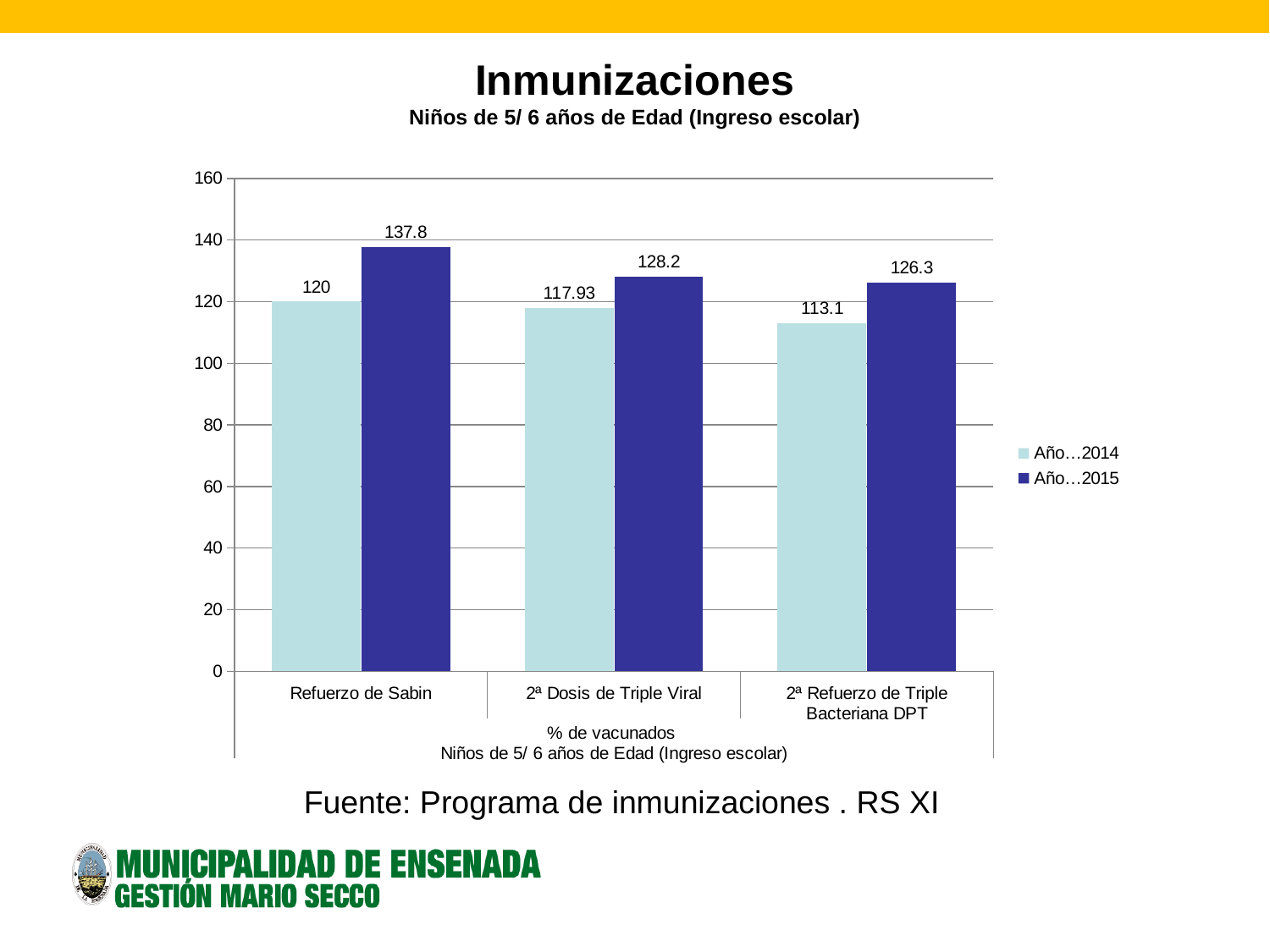
What is the difference between the Año…2015 and Año…2014 values for Refuerzo de Sabin? 17.8 Which is larger for 2ª Dosis de Triple Viral: the Año…2014 value or the Año…2015 value? Año…2015 What is the value for 2ª Refuerzo de Triple Bacteriana DPT in Año…2014? 113.1 What is the title of the chart? Inmunizaciones Is the Año…2015 value for 2ª Refuerzo de Triple Bacteriana DPT greater or less than 120? greater How many categories are shown on the x axis? 3 How many series does the legend list? 2 What is the value for Refuerzo de Sabin in Año…2014? 120 What kind of chart is shown on the slide? bar chart Which category has the lowest value in Año…2014? 2ª Refuerzo de Triple Bacteriana DPT What is the value for 2ª Dosis de Triple Viral in Año…2015? 128.2 Which category has the highest value in Año…2015? Refuerzo de Sabin